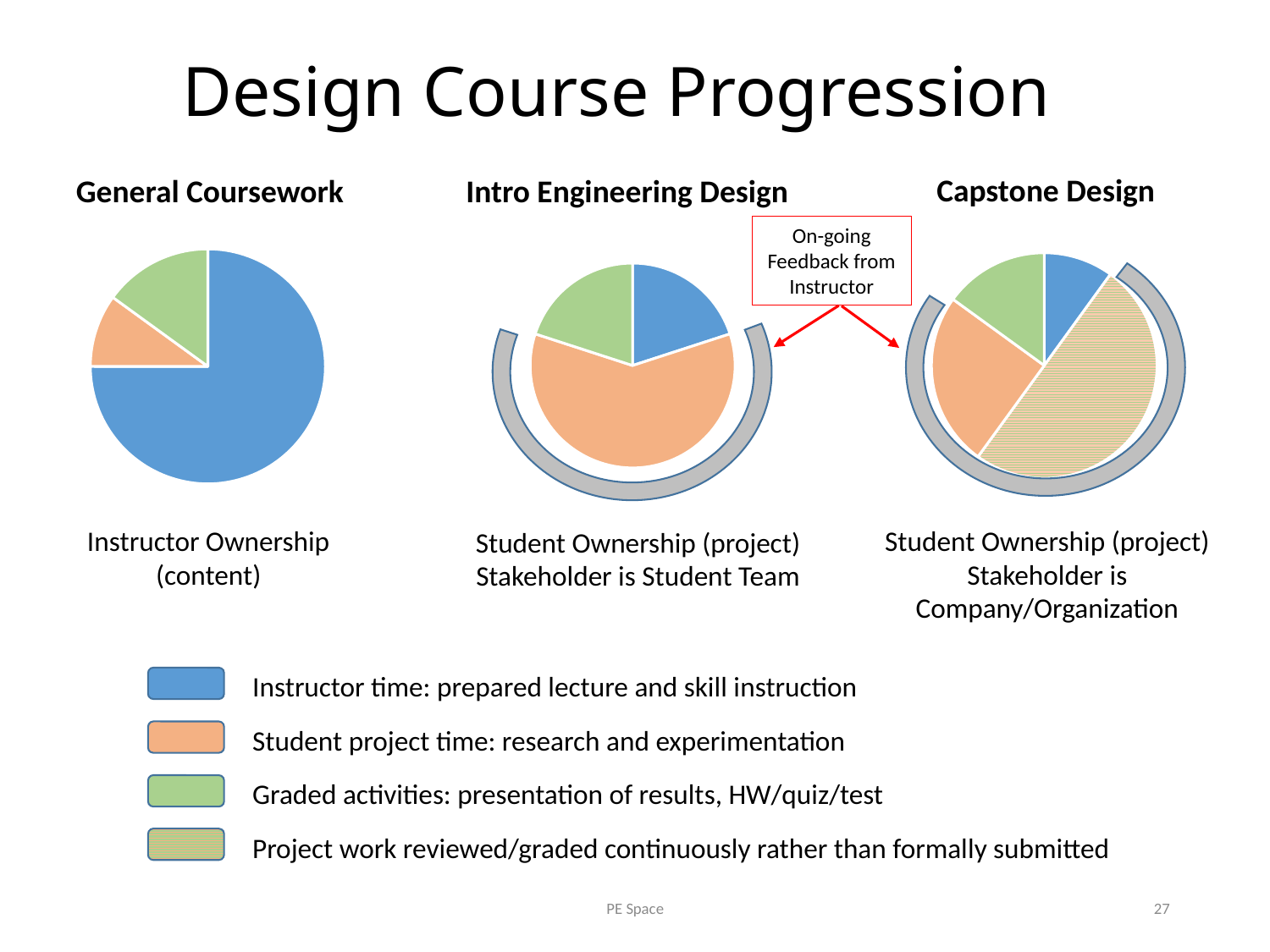
In the Capstone Design pie chart, which category takes the largest share? Project work reviewed/graded continuously rather than formally submitted In the Intro Engineering Design pie chart, which is larger: the Student project time slice or the Graded activities slice? Student project time How many entries does the legend at the bottom of the slide list? 4 What is the title of the slide containing the three pie charts? Design Course Progression In the Intro Engineering Design pie chart, which category takes the largest share? Student project time: research and experimentation What does the callout box with red arrows pointing to the Intro Engineering Design and Capstone Design charts say? On-going Feedback from Instructor How many slices does the General Coursework pie chart have? 3 How many slices does the Capstone Design pie chart have? 4 What kind of chart is used for General Coursework? Pie chart In the General Coursework pie chart, which is larger: the Instructor time slice or the Student project time slice? Instructor time In the Capstone Design pie chart, which category takes the smallest share? Instructor time: prepared lecture and skill instruction In the General Coursework pie chart, which category takes the largest share? Instructor time: prepared lecture and skill instruction